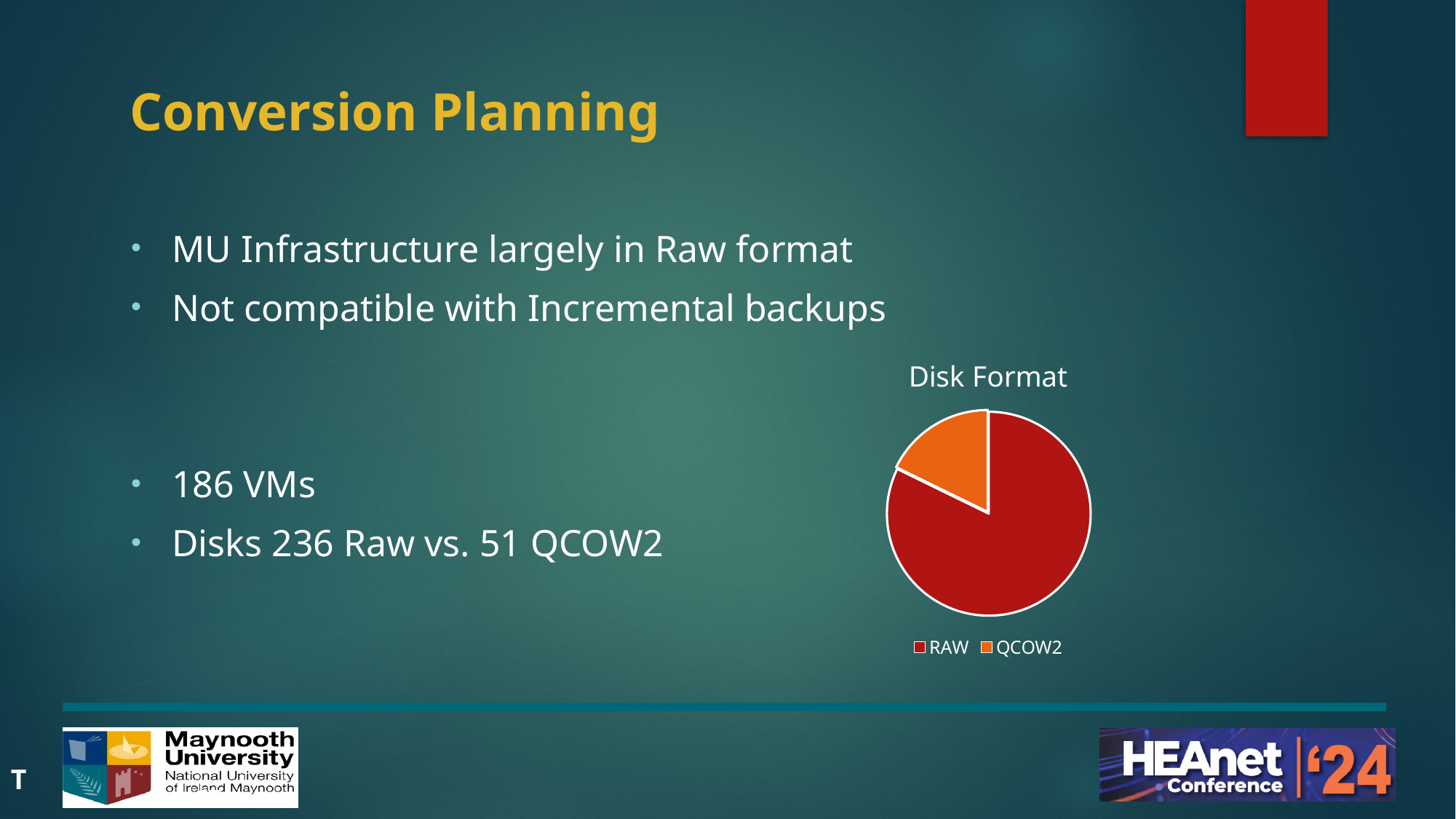
Which disk format has the largest slice in the Disk Format pie chart? RAW What is the title of the chart? Disk Format Which disk format has the smallest slice in the Disk Format pie chart? QCOW2 Does the RAW slice take up more or less than half of the Disk Format pie chart? more What kind of chart is shown on the slide? pie chart According to the slide, how many disks are in QCOW2 format? 51 How many slices does the Disk Format pie chart have? 2 How many more Raw disks than QCOW2 disks are there according to the slide? 185 What colour is the RAW slice in the Disk Format pie chart? red According to the slide, how many disks are in Raw format? 236 How many entries does the legend of the Disk Format chart list? 2 Which slice is larger in the Disk Format pie chart, RAW or QCOW2? RAW